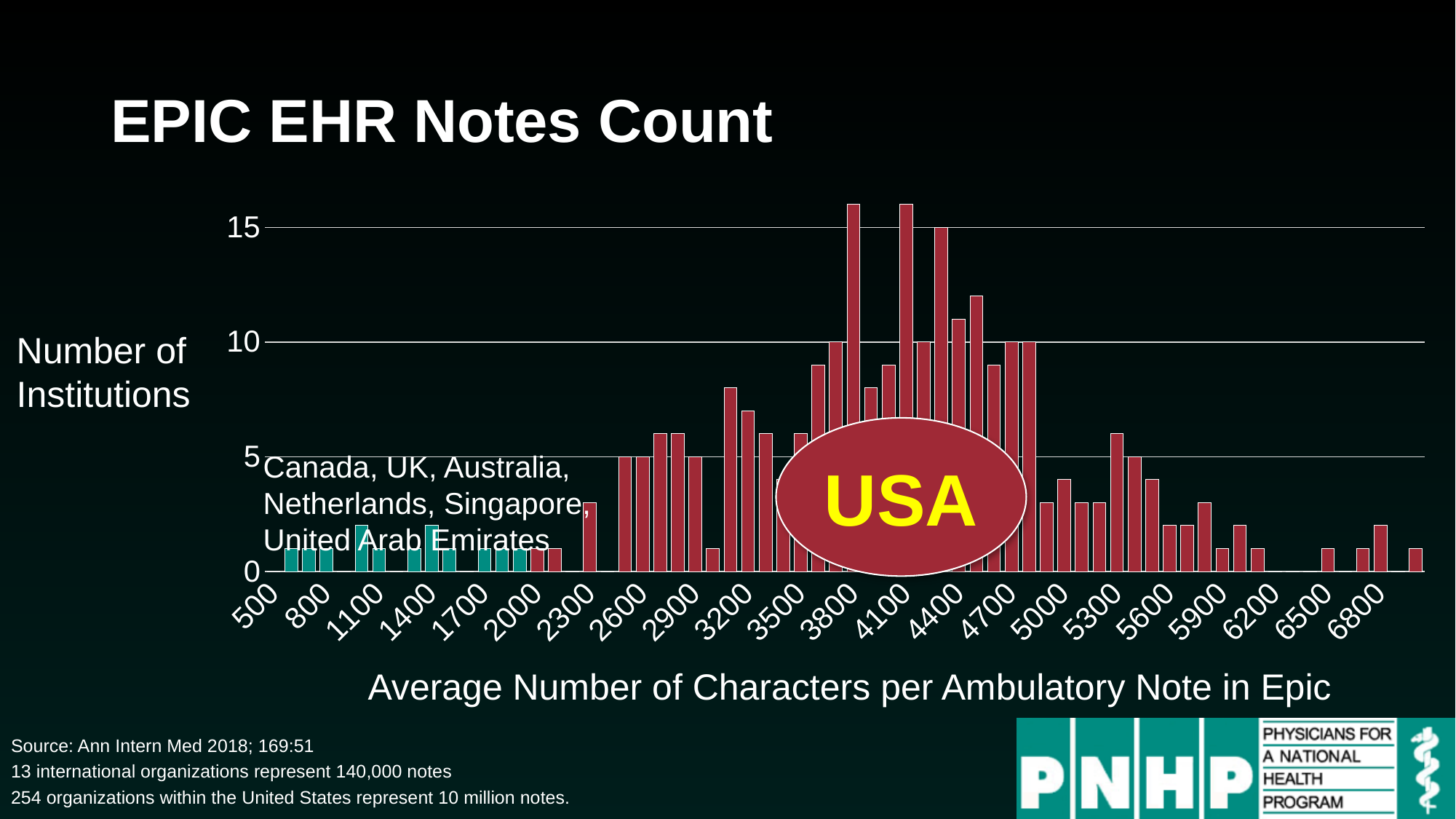
Which is larger: the value for 500 or the tallest bar near 3800? the tallest bar near 3800 What is the highest value shown on the y axis of the chart? 15 Is the value for 500 greater or less than 5? less What kind of chart is shown on the slide? bar chart Is the value for 6800 greater or less than 5? less Is the tallest bar in the chart greater or less than 15? greater Do the bar heights generally rise or fall moving along the x axis from 4700 to 6800? fall Do the bar heights generally rise or fall moving along the x axis from 500 to 3800? rise How many tick labels are shown along the x axis of the chart? 22 What is the title of the chart on the slide? EPIC EHR Notes Count What is the label on the x axis of the chart? Average Number of Characters per Ambulatory Note in Epic